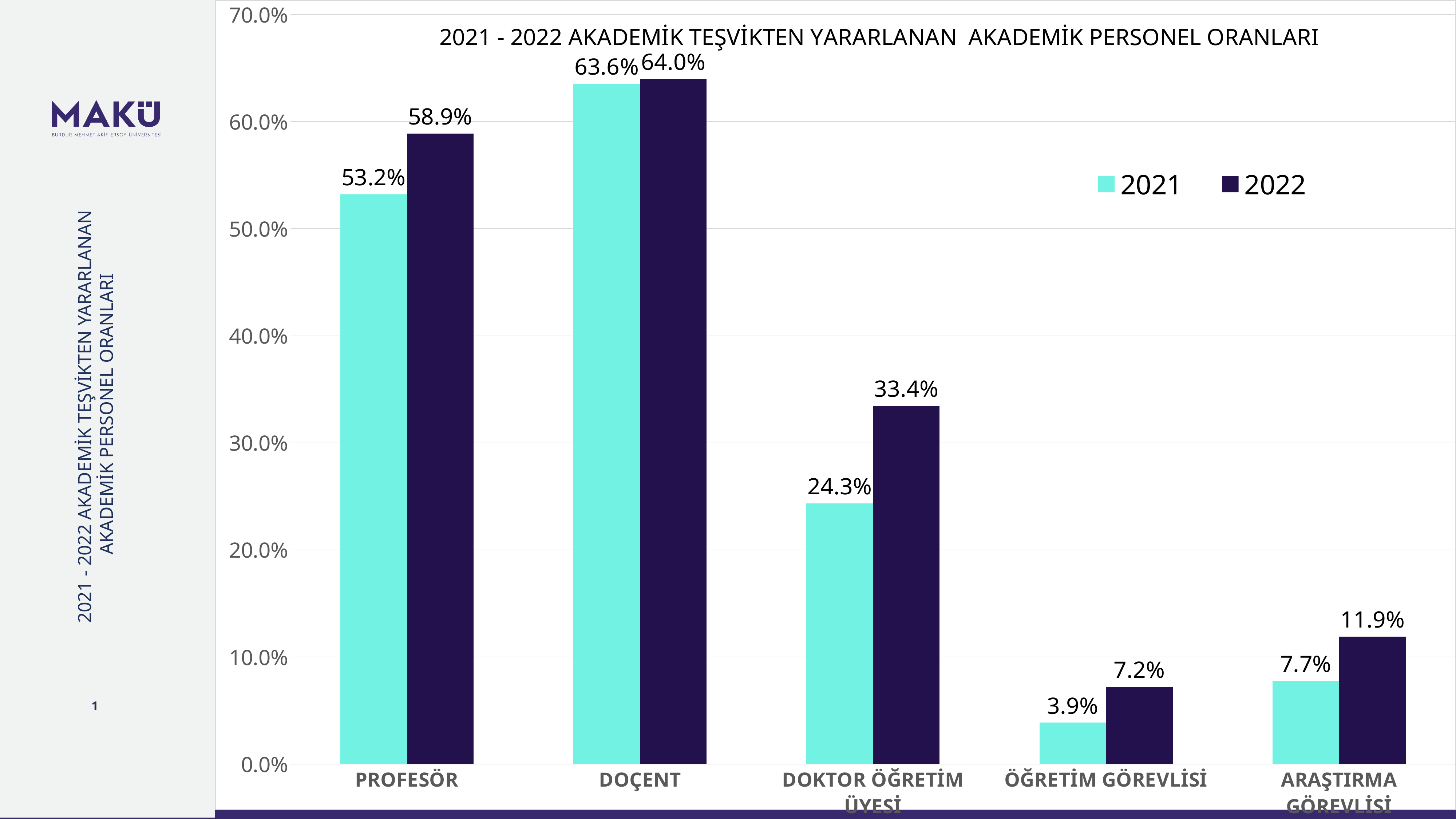
What is the 2021 value for PROFESÖR? 53.2% Which series is shown in dark purple in the legend? 2022 How many categories are shown on the x axis? 5 What is the difference between the 2022 and 2021 values for DOKTOR ÖĞRETİM ÜYESİ? 9.1% Which category has the highest 2022 value? DOÇENT What is the difference between the 2022 and 2021 values for PROFESÖR? 5.7% Which is larger: the 2022 value for ARAŞTIRMA GÖREVLİSİ or the 2022 value for ÖĞRETİM GÖREVLİSİ? ARAŞTIRMA GÖREVLİSİ Which category has the lowest 2021 value? ÖĞRETİM GÖREVLİSİ How many series does the legend list? 2 What is the 2022 value for DOKTOR ÖĞRETİM ÜYESİ? 33.4% What kind of chart is shown on the slide? Bar chart What is the 2021 value for ÖĞRETİM GÖREVLİSİ? 3.9%